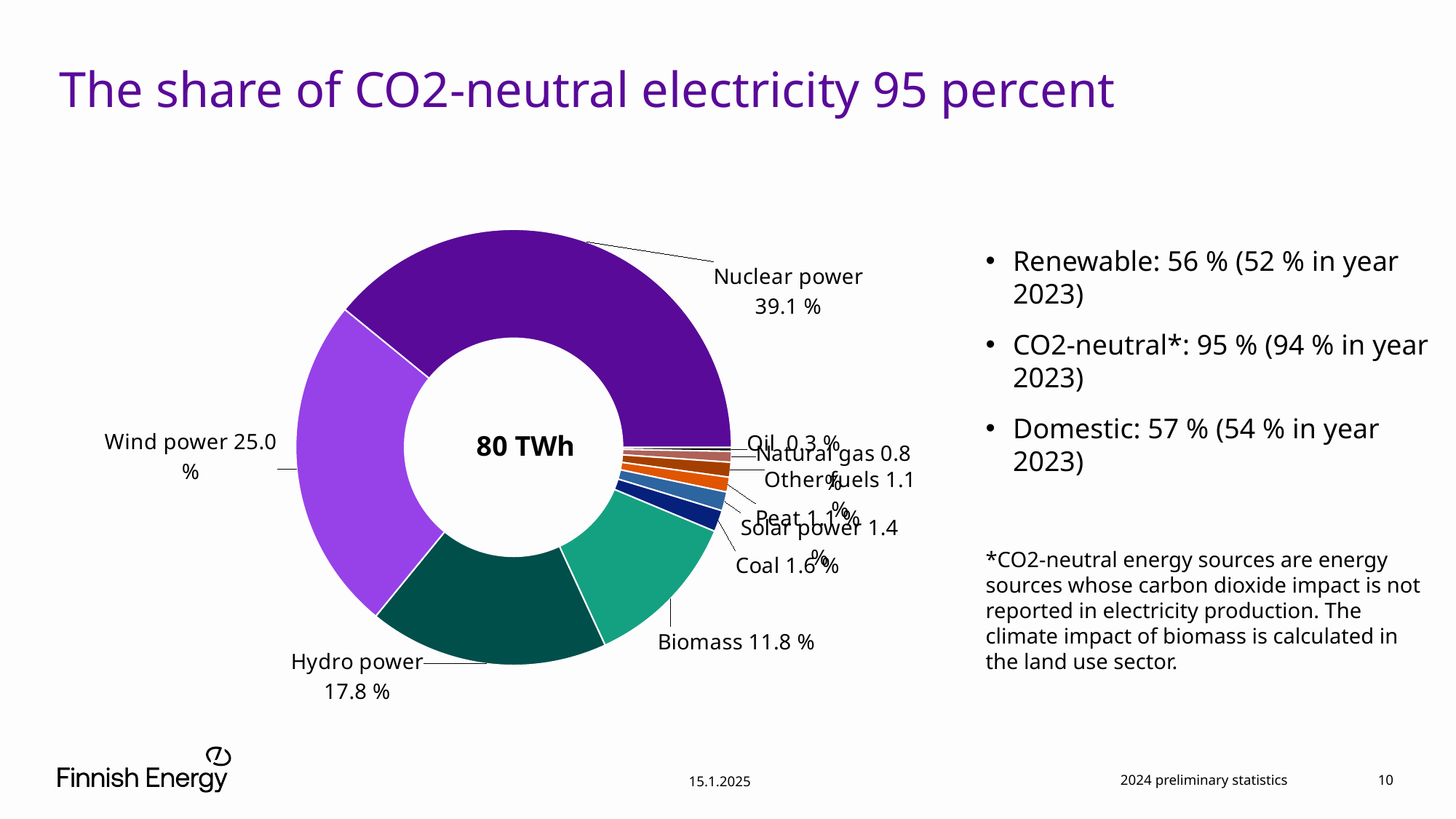
What share of electricity does wind power have in the chart? 25.0 % Which energy source has the smallest share in the chart? Oil What kind of chart is shown on the slide? Doughnut (pie) chart What share of electricity does biomass have in the chart? 11.8 % What share of electricity does hydro power have in the chart? 17.8 % Which energy source has the largest share in the chart? Nuclear power What share of electricity does nuclear power have in the chart? 39.1 % What total amount of electricity is shown in the centre of the chart? 80 TWh What is the difference in percentage points between the shares of nuclear power and wind power? 14.1 What share of electricity does coal have in the chart? 1.6 % How many energy sources are shown in the chart? 10 Which has a larger share, hydro power or biomass? Hydro power